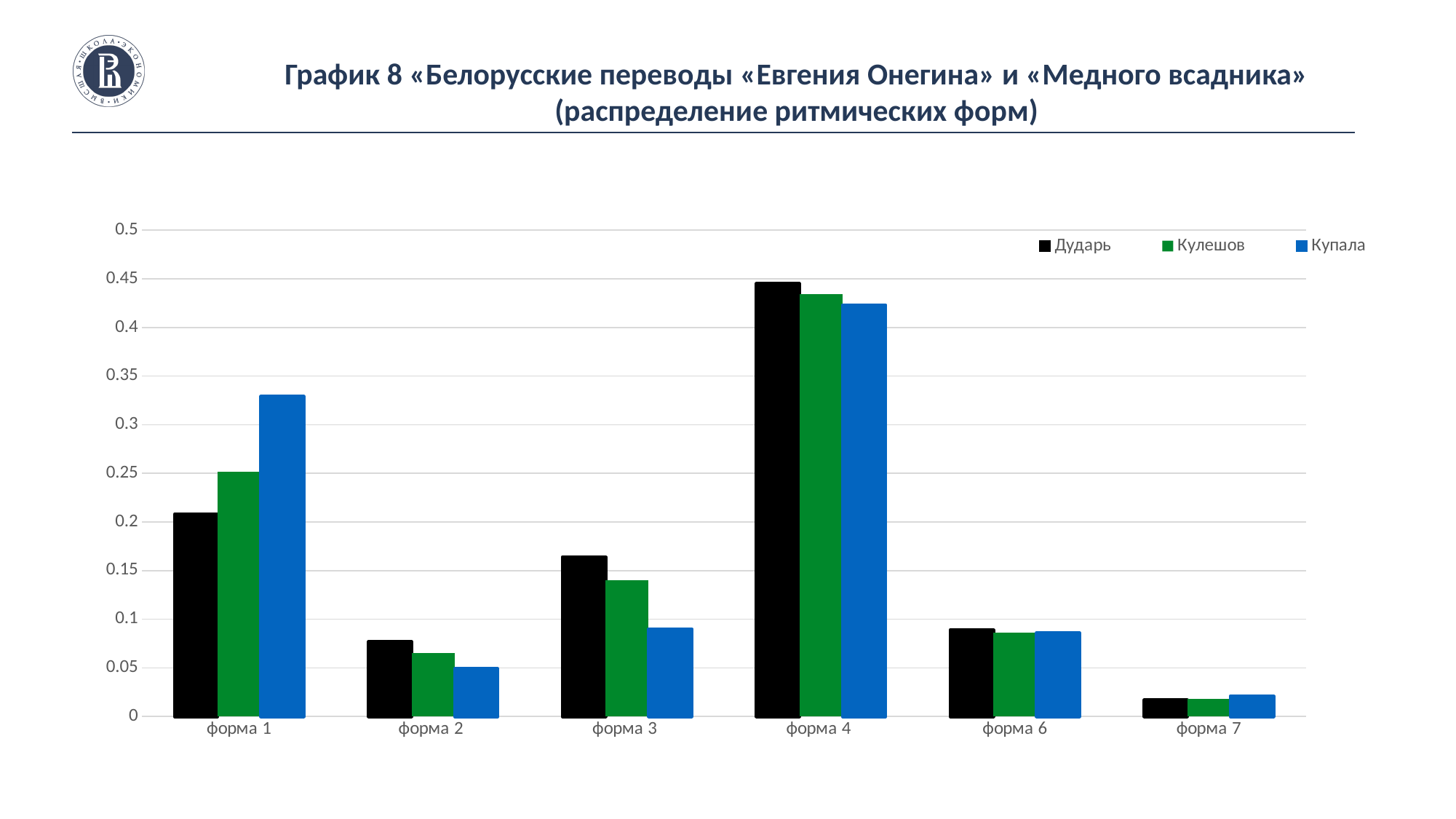
For which form is the value for Купала the lowest? форма 7 At форма 1, which is larger: the value for Купала or the value for Дударь? Купала Is the value for Купала at форма 3 greater or less than 0.1? less At форма 3, which is larger: the value for Дударь or the value for Купала? Дударь For which form is the value for Дударь the highest? форма 4 Which series is shown in black? Дударь Is the value for Дударь at форма 4 greater or less than 0.4? greater How many categories (forms) are shown on the x axis? 6 What kind of chart is shown on the slide? bar chart Which colour represents the series Кулешов in the legend? green How many series does the legend list? 3 Is the value for Купала at форма 1 greater or less than 0.3? greater